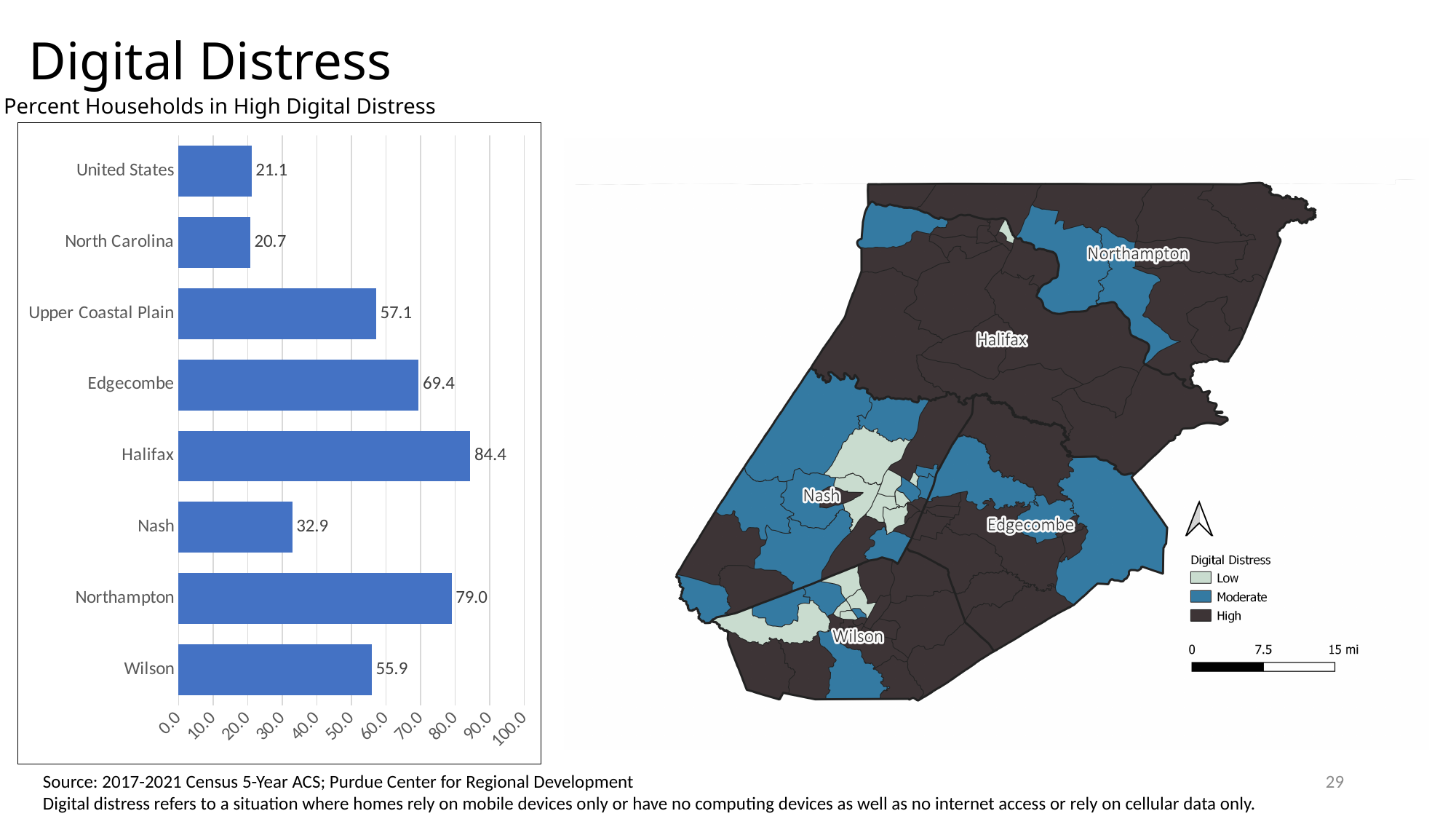
What is the value for North Carolina in the bar chart? 20.7 What kind of chart is shown on the left of the slide? Bar chart How many categories are shown in the bar chart? 8 Is the value for Upper Coastal Plain in the bar chart greater or less than 50.0? greater Which is larger in the bar chart, the value for Northampton or the value for Wilson? Northampton What is the difference between the values for Upper Coastal Plain and United States in the bar chart? 36.0 Which category has the highest value in the bar chart? Halifax What is the title of the bar chart on the slide? Percent Households in High Digital Distress What is the difference between the values for Halifax and Edgecombe in the bar chart? 15.0 Which category has the lowest value in the bar chart? North Carolina What is the value for Halifax in the Percent Households in High Digital Distress chart? 84.4 What is the value for Nash in the bar chart? 32.9